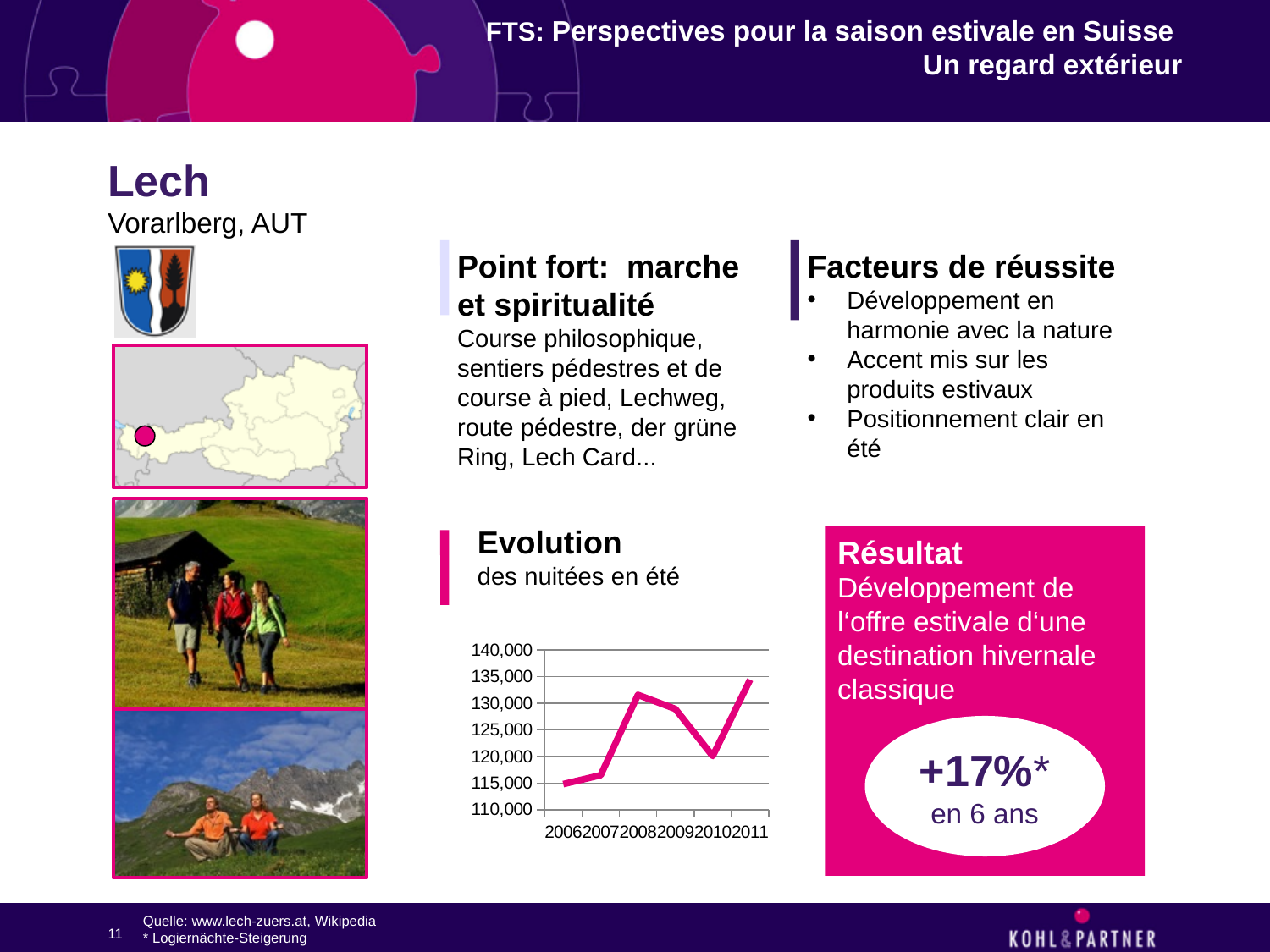
Is the value for 2011 greater or less than 130,000? greater Is the value for 2008 greater or less than 125,000? greater Which year has the lowest value in the chart? 2006 Which year has the larger value, 2008 or 2010? 2008 What kind of chart is shown under 'Evolution des nuitées en été'? line chart Is the value for 2009 greater or less than 125,000? greater Which year has the highest value in the chart? 2011 How many years are plotted on the x axis of the chart? 6 Overall, do the values rise or fall from 2006 to 2011? rise Which years does the chart cover? 2006 to 2011